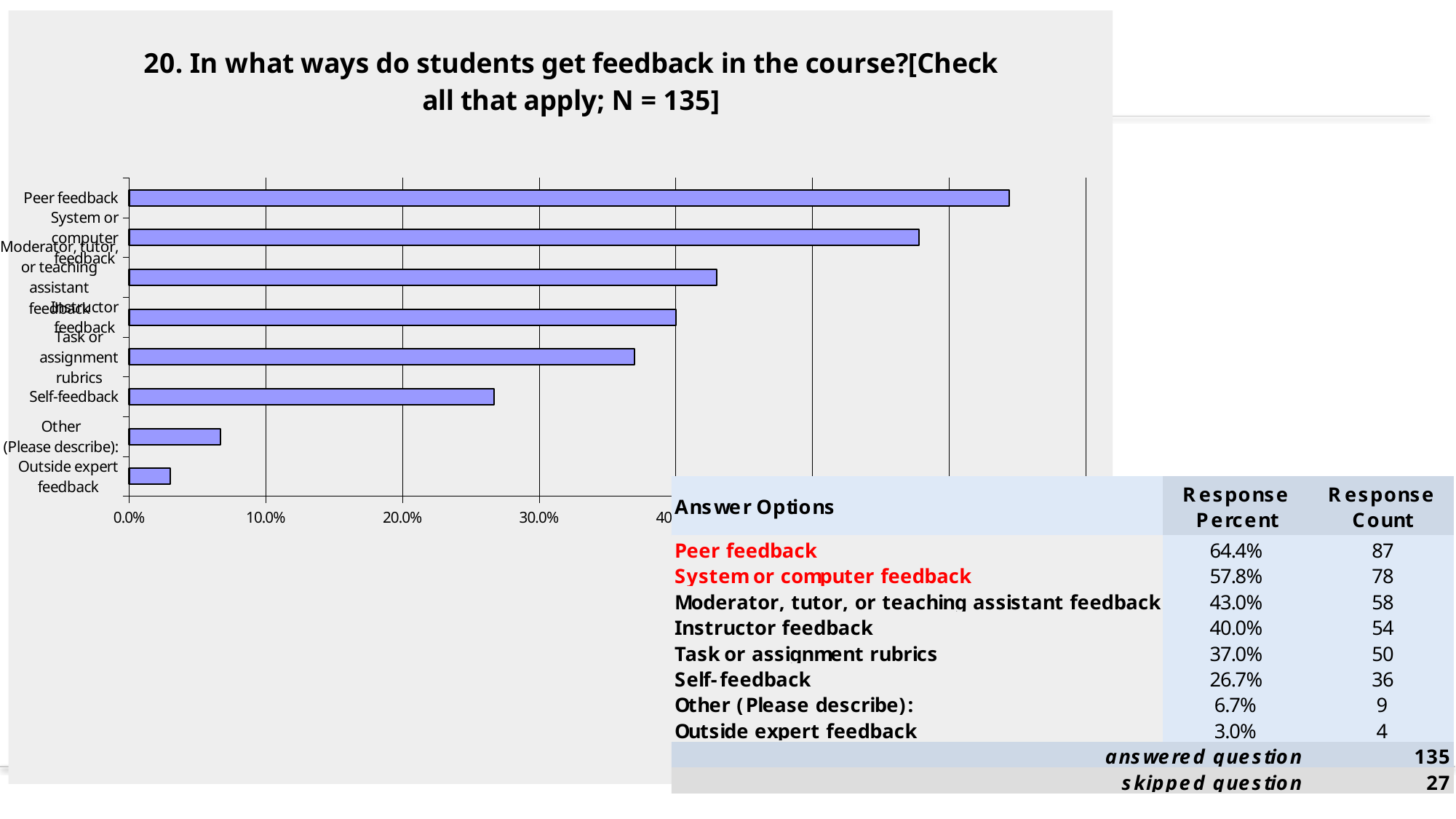
What is the response count for Instructor feedback? 54 Which is larger, the value for Instructor feedback or the value for Task or assignment rubrics? Instructor feedback What kind of chart is shown on the slide? Bar chart How many categories (answer options) are plotted in the chart? 8 What is the difference in response percent between Peer feedback and System or computer feedback? 6.6% What is the response percent for Self-feedback? 26.7% Which category has the lowest value in the chart? Outside expert feedback Is the value for Moderator, tutor, or teaching assistant feedback greater or less than 30.0%? greater Which category has the highest value in the chart? Peer feedback What is the N (number of respondents) stated in the chart title? 135 Is the value for Other (Please describe) greater or less than 10.0%? less What is the response percent for Peer feedback? 64.4%